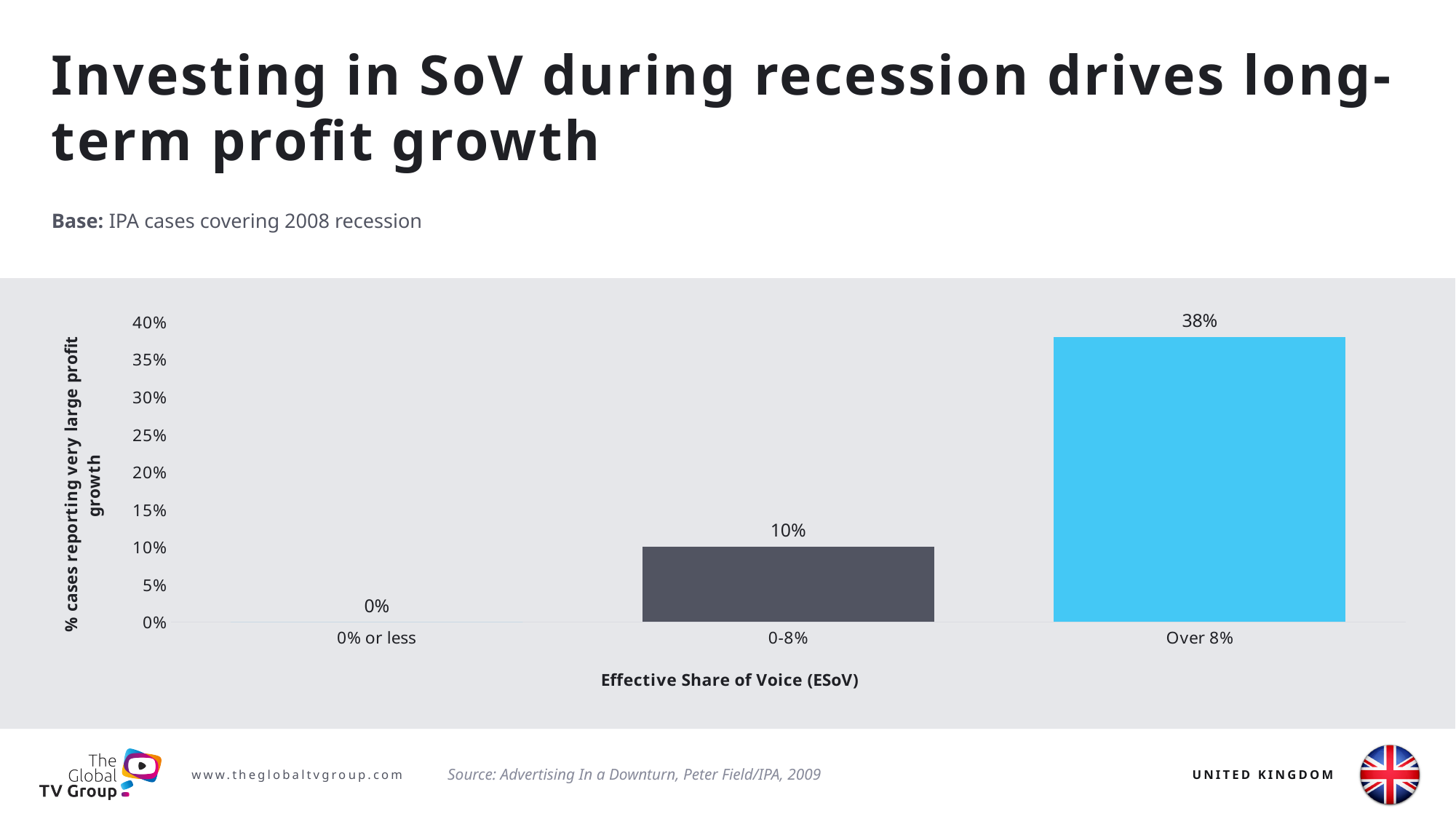
Which ESoV category has the highest percentage of cases reporting very large profit growth? Over 8% Is the value for 'Over 8%' greater or less than 35%? greater Which is larger: the value for '0-8%' or the value for 'Over 8%'? Over 8% What is the value shown for the '0-8%' ESoV category? 10% Do the values rise or fall moving from left to right along the x axis? Rise What is the label of the x axis? Effective Share of Voice (ESoV) What percentage of cases reported very large profit growth for the 'Over 8%' ESoV category? 38% Which ESoV category has the lowest percentage of cases reporting very large profit growth? 0% or less What is the value shown for the '0% or less' ESoV category? 0% What kind of chart is shown on the slide? Bar chart How many ESoV categories are shown on the x axis? 3 What is the difference in percentage points between the 'Over 8%' and '0-8%' categories? 28 percentage points